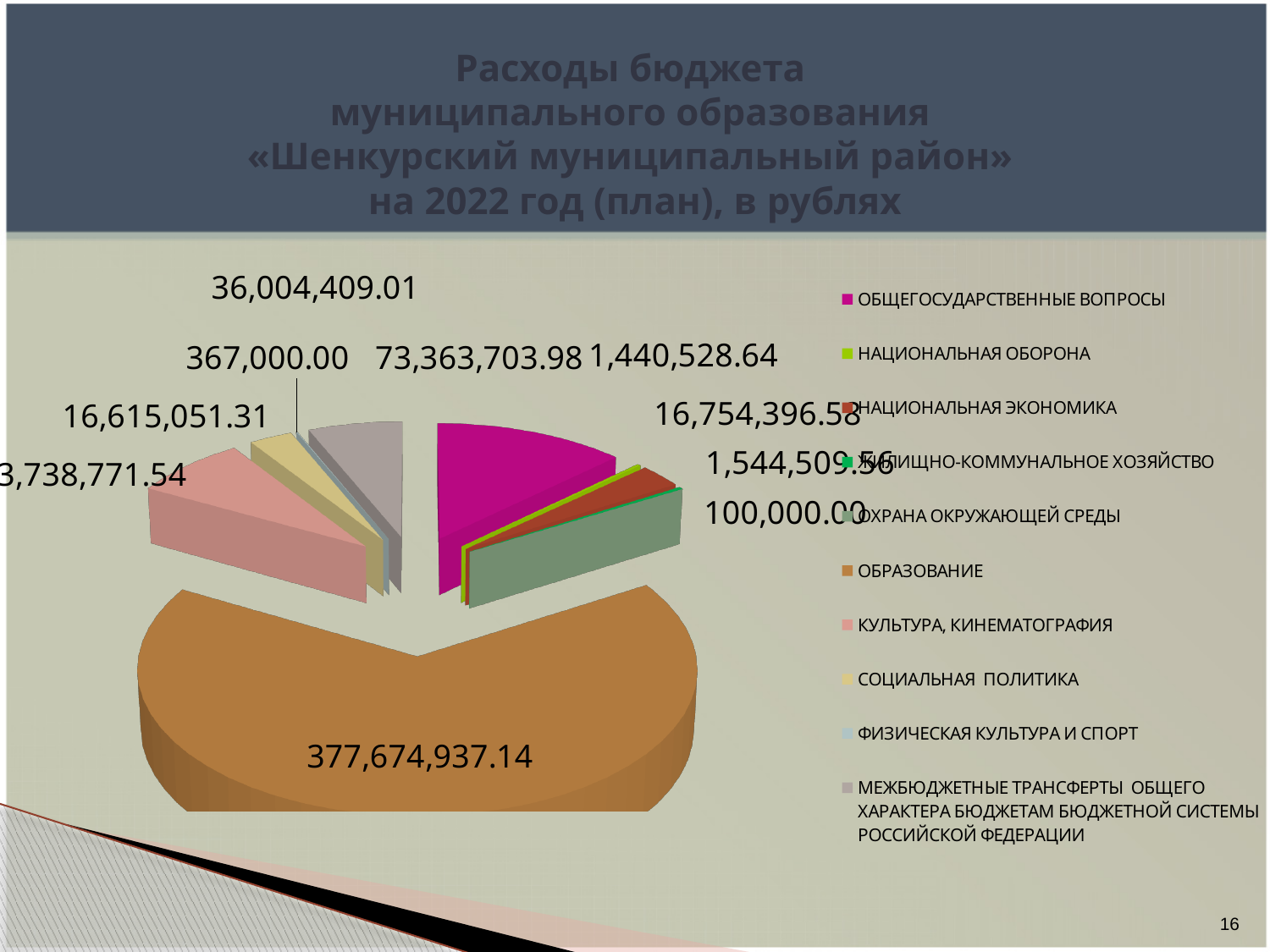
What is the value shown for ФИЗИЧЕСКАЯ КУЛЬТУРА И СПОРТ? 367,000.00 Which category has the largest share of the pie chart? ОБРАЗОВАНИЕ How many categories does the legend of the pie chart list? 10 What is the value shown for ОБЩЕГОСУДАРСТВЕННЫЕ ВОПРОСЫ? 73,363,703.98 What is the value shown for МЕЖБЮДЖЕТНЫЕ ТРАНСФЕРТЫ ОБЩЕГО ХАРАКТЕРА БЮДЖЕТАМ БЮДЖЕТНОЙ СИСТЕМЫ РОССИЙСКОЙ ФЕДЕРАЦИИ? 36,004,409.01 What is the difference between the value for ОБЩЕГОСУДАРСТВЕННЫЕ ВОПРОСЫ and the value for МЕЖБЮДЖЕТНЫЕ ТРАНСФЕРТЫ ОБЩЕГО ХАРАКТЕРА БЮДЖЕТАМ БЮДЖЕТНОЙ СИСТЕМЫ РОССИЙСКОЙ ФЕДЕРАЦИИ? 37,359,294.97 What kind of chart is shown on the slide? Pie chart What is the smallest value labelled on the pie chart? 100,000.00 What is the value shown for ОБРАЗОВАНИЕ? 377,674,937.14 What colour is the ОБРАЗОВАНИЕ slice in the pie chart? Brown For which year does the chart title say the budget expenditures are planned? 2022 Which is larger: the value for ОБРАЗОВАНИЕ or the value for ОБЩЕГОСУДАРСТВЕННЫЕ ВОПРОСЫ? ОБРАЗОВАНИЕ